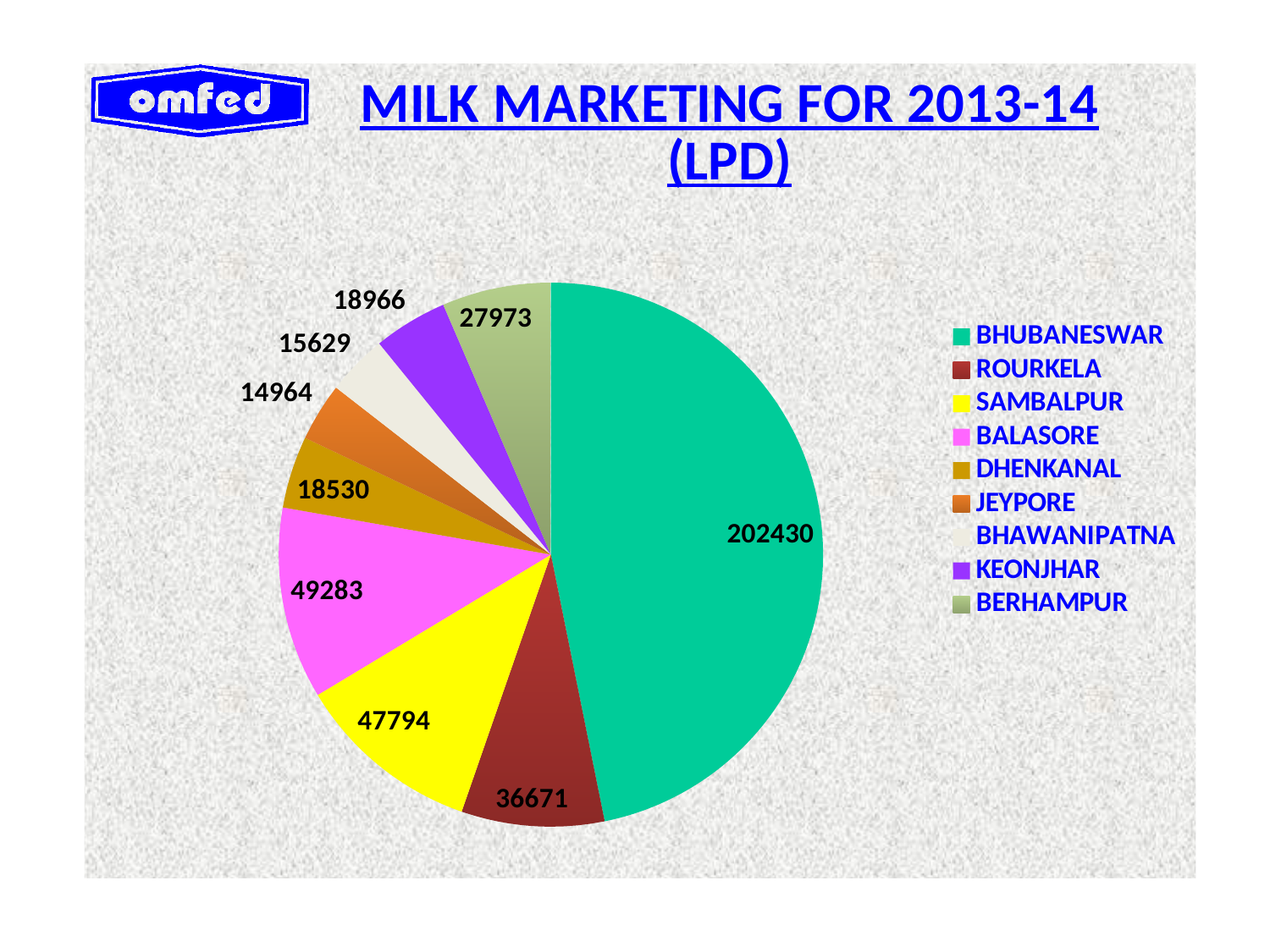
What is the difference between the values for BALASORE and SAMBALPUR? 1489 Which has a larger value, KEONJHAR or DHENKANAL? KEONJHAR Which dairy has the largest share of milk marketing for 2013-14? BHUBANESWAR What is the difference between the values for BERHAMPUR and BHAWANIPATNA? 12344 What is the value shown for JEYPORE? 14964 What is the milk marketing value for BHUBANESWAR? 202430 How many dairies (slices) are shown in the pie chart? 9 What type of chart is shown on the slide? Pie chart What is the total of all values in the pie chart? 432240 What is the value shown for BALASORE? 49283 What is the title of the chart? MILK MARKETING FOR 2013-14 (LPD) Which dairy has the smallest value in the pie chart? JEYPORE